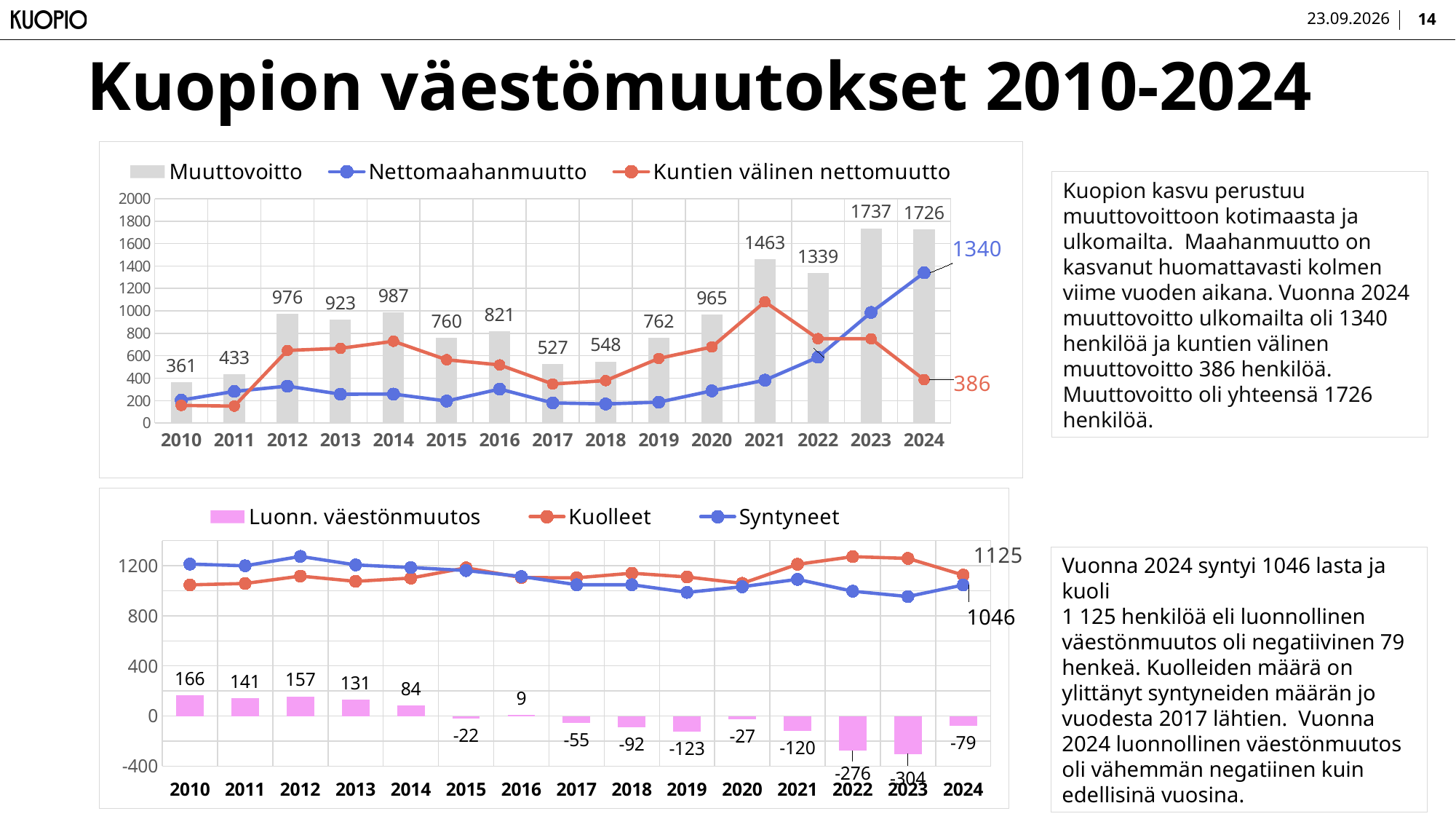
In the top chart, is the Nettomaahanmuutto value for 2018 greater or less than 400? less In the top chart, what is the difference between the Muuttovoitto values for 2023 and 2024? 11 In the top chart, which year has the lowest Muuttovoitto? 2010 In the bottom chart, which is larger in 2024, Kuolleet or Syntyneet? Kuolleet In the top chart, what is the Muuttovoitto value for 2023? 1737 In the top chart, which year has the highest Muuttovoitto? 2023 In the top chart, what is the Nettomaahanmuutto value labelled for 2024? 1340 In the bottom chart, which year has the highest Luonn. väestönmuutos? 2010 In the bottom chart, what is the Luonn. väestönmuutos value for 2023? -304 In the bottom chart, how many years are shown on the x axis? 15 In the top chart, how many series does the legend list? 3 In the top chart, what is the Muuttovoitto value for 2010? 361